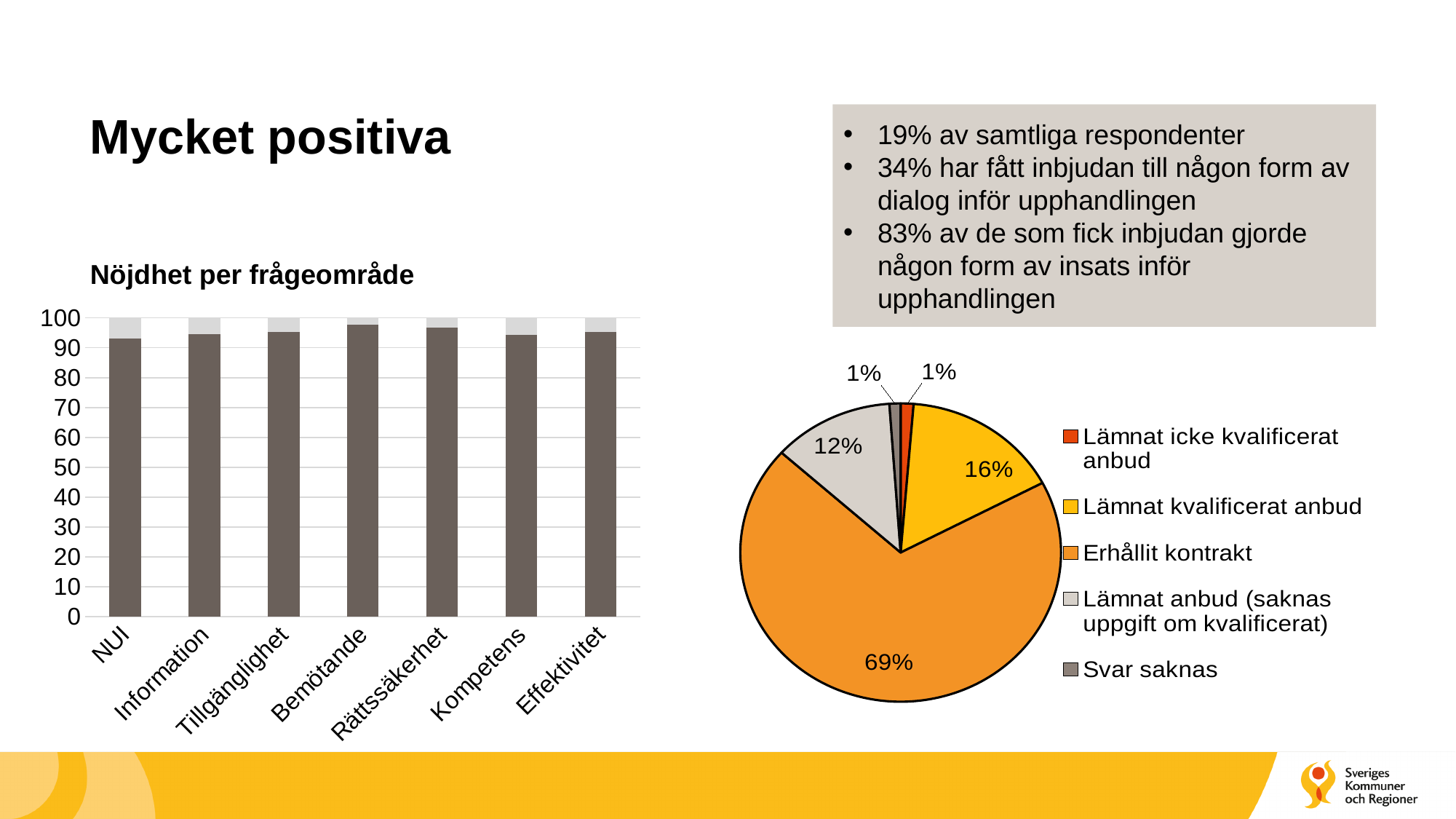
In the 'Nöjdhet per frågeområde' bar chart, is the dark grey value for Effektivitet greater or less than 80? greater In the pie chart on the right, which category has the largest slice? Erhållit kontrakt In the 'Nöjdhet per frågeområde' bar chart, is the dark grey value for Bemötande greater or less than 90? greater How many entries does the legend of the pie chart on the right list? 5 How many categories are shown on the x axis of the 'Nöjdhet per frågeområde' bar chart? 7 What kind of chart is the 'Nöjdhet per frågeområde' chart on the left? bar chart In the pie chart on the right, what share does 'Erhållit kontrakt' have? 69% What kind of chart is the chart on the right of the slide? pie chart In the pie chart on the right, what share does 'Lämnat kvalificerat anbud' have? 16% In the 'Nöjdhet per frågeområde' bar chart, is the dark grey value for NUI greater or less than 90? greater In the pie chart on the right, what share does 'Lämnat anbud (saknas uppgift om kvalificerat)' have? 12% In the pie chart on the right, what is the difference in percentage points between 'Erhållit kontrakt' and 'Lämnat kvalificerat anbud'? 53